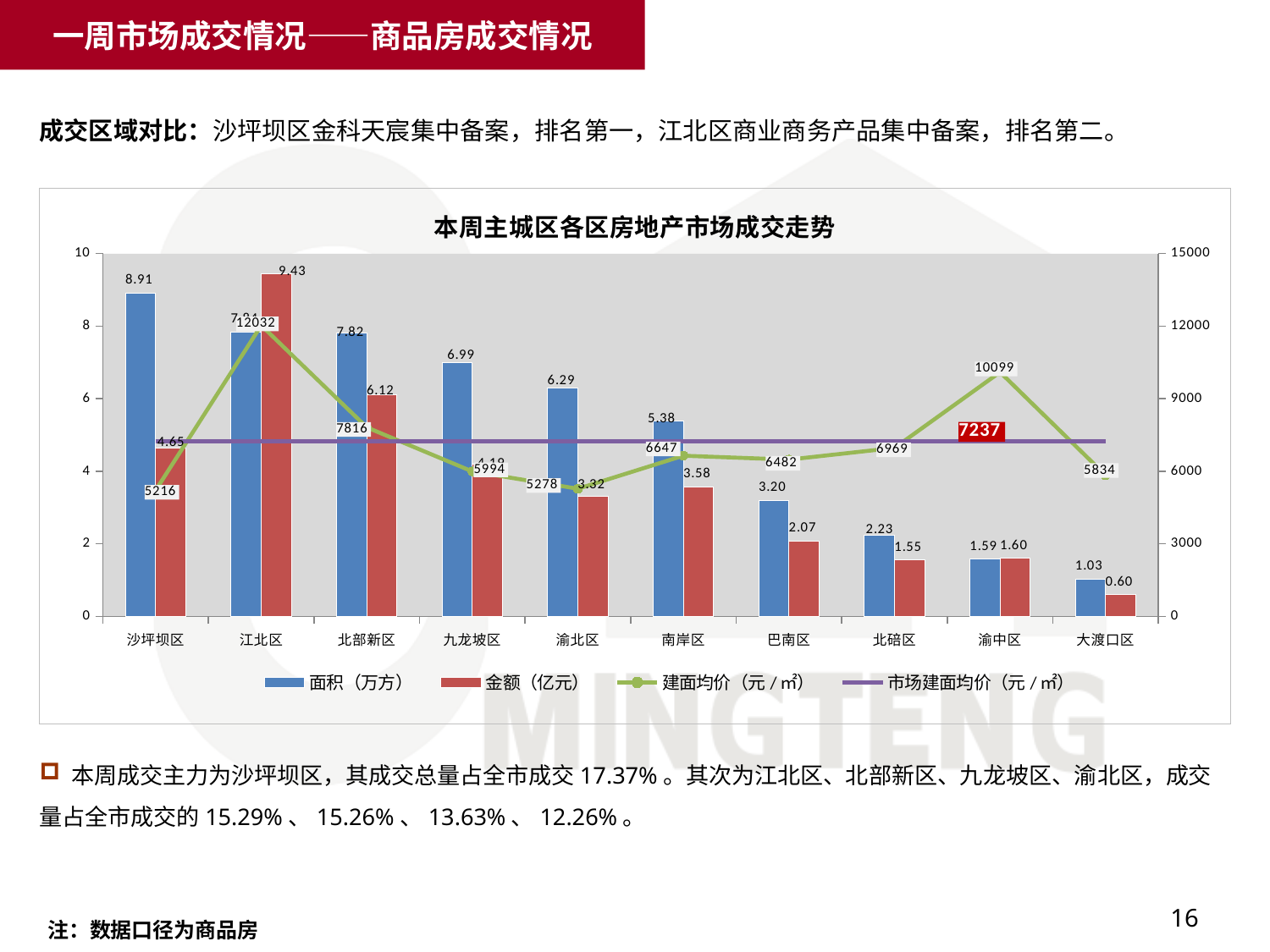
What is the 建面均价（元/㎡） value for 渝中区? 10099 Does the 面积（万方） series rise or fall from left to right along the x axis? fall What is the difference between 面积（万方） and 金额（亿元） for 北部新区? 1.70 Which district has the highest 建面均价（元/㎡）? 江北区 How many series does the legend list? 4 Which district has the lowest 面积（万方）? 大渡口区 What is the value of the 市场建面均价（元/㎡） line? 7237 Which district has the lowest 金额（亿元）? 大渡口区 For 南岸区, which is larger: 面积（万方） or 金额（亿元）? 面积（万方） What is the 面积（万方） value for 沙坪坝区? 8.91 How many districts are shown on the x axis? 10 What is the 金额（亿元） value for 江北区? 9.43